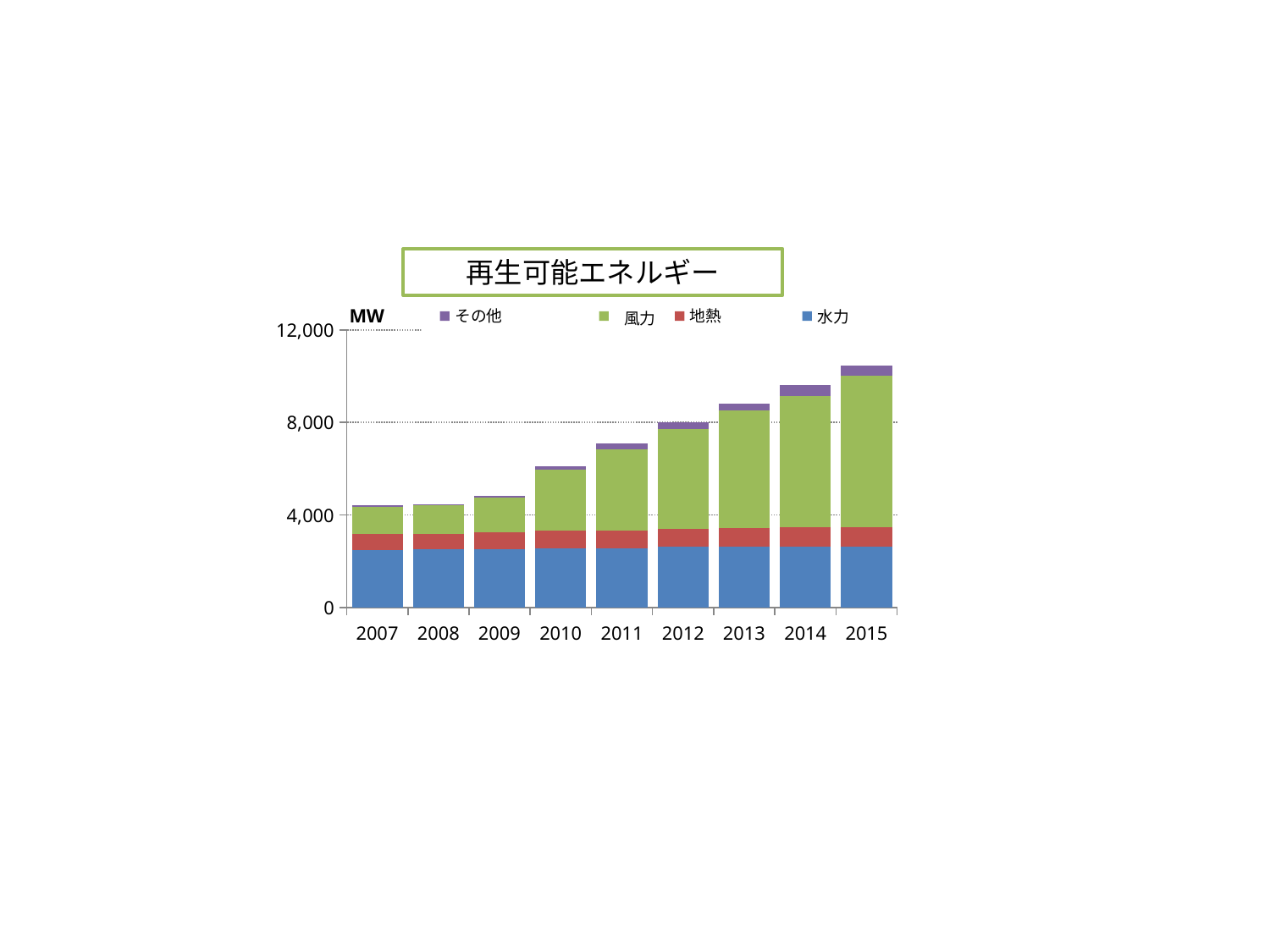
Which year has the highest total stacked bar? 2015 Is the total value for 2015 greater or less than 8,000? greater What unit is shown at the top of the y axis? MW Is the total value for 2010 greater or less than 4,000? greater Is the 水力 value for 2015 greater or less than 4,000? less Do the total values rise or fall from 2007 to 2015? rise How many series does the legend list? 4 What is the title of the chart? 再生可能エネルギー Which year has the larger total, 2013 or 2010? 2013 What kind of chart is shown on the slide? stacked bar chart How many years are shown on the x axis? 9